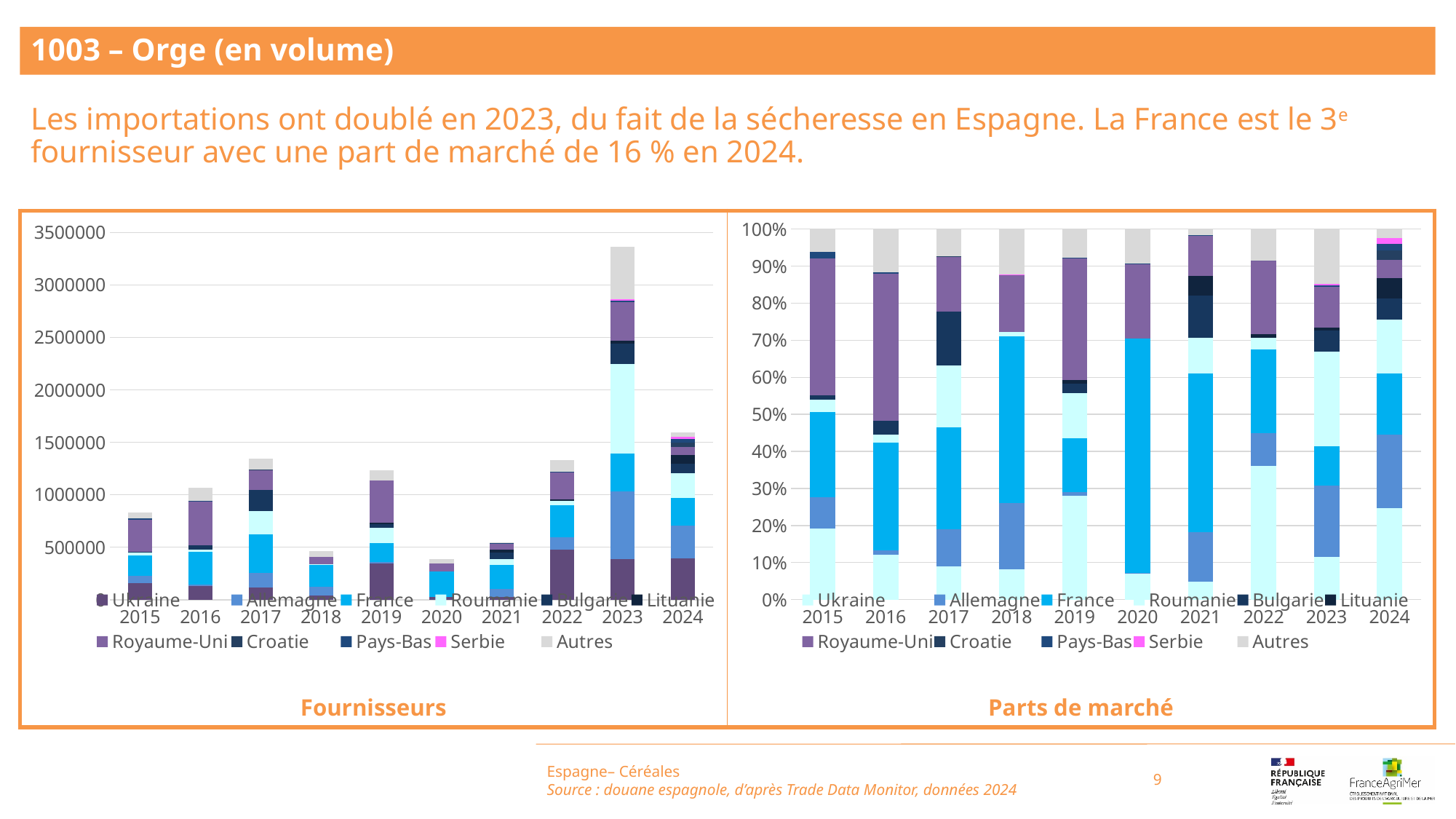
In the 'Parts de marché' chart, is the share of Ukraine in 2024 greater or less than 20%? greater What is the first series listed in the legend of the 'Fournisseurs' chart? Ukraine What kind of chart is the 'Fournisseurs' chart on the left? Stacked bar chart In the 'Fournisseurs' chart, which year has the larger total, 2023 or 2024? 2023 What is the title shown under the right-hand chart? Parts de marché How many years are shown on the x axis of the 'Fournisseurs' chart? 10 In the 'Fournisseurs' chart, is the total for 2020 greater or less than 500000? less In the 'Fournisseurs' chart, which year has the highest total import volume? 2023 In the 'Fournisseurs' chart, which year has the lowest total import volume? 2020 In the 'Fournisseurs' chart, is the total for 2023 greater or less than 3000000? greater How many series does the legend of the 'Parts de marché' chart list? 11